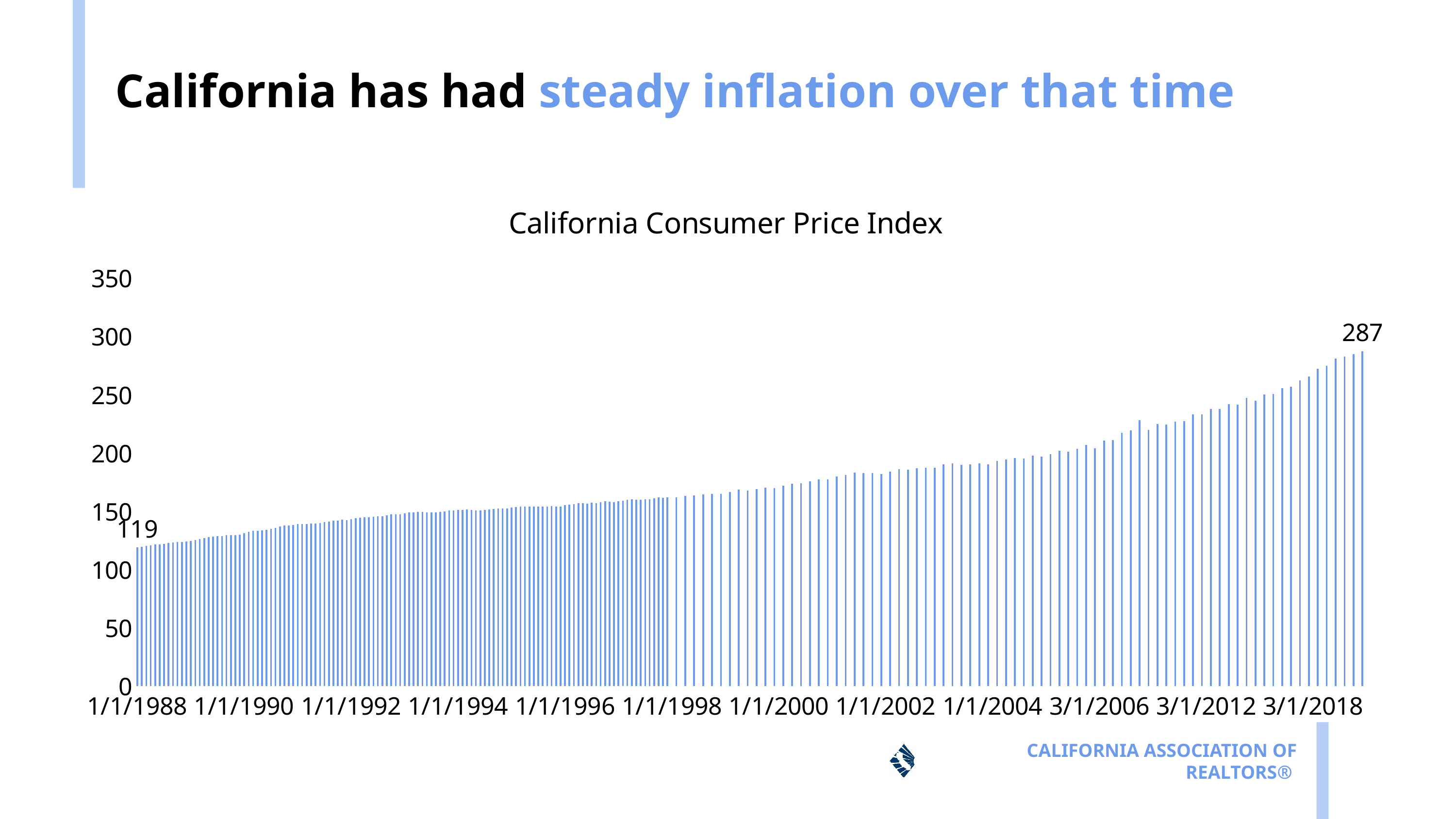
What is the title of the chart on the slide? California Consumer Price Index Do the values in the California Consumer Price Index chart rise or fall over time from 1988 onward? Rise What kind of chart is used to show the California Consumer Price Index? Bar chart What is the value of the last bar in the California Consumer Price Index chart? 287 Is the value for 1/1/2004 greater or less than 200? less What is the value of the first bar (1/1/1988) in the California Consumer Price Index chart? 119 Which bar has the highest value in the California Consumer Price Index chart, the first or the last? The last Is the value for 1/1/1988 larger or smaller than the value for 3/1/2018? Smaller Is the value for 1/1/1992 greater or less than 150? less Which bar has the lowest value in the California Consumer Price Index chart, the first or the last? The first What is the difference between the last labelled value (287) and the first labelled value (119) in the chart? 168 Is the value for 1/1/1998 greater or less than 150? greater